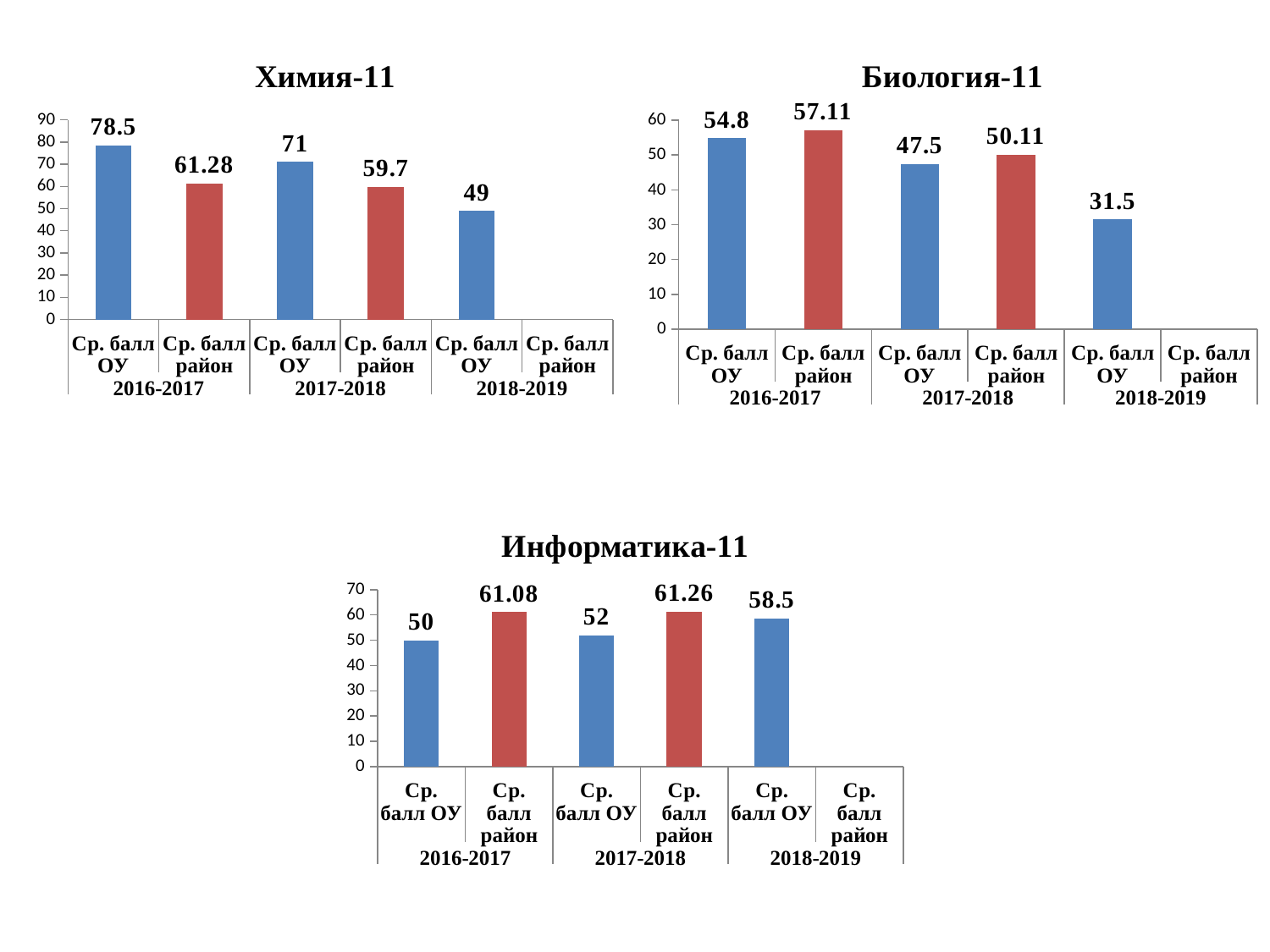
In the Химия-11 chart, what is the value for Ср. балл район in 2017-2018? 59.7 In the Химия-11 chart, what is the value for Ср. балл ОУ in 2016-2017? 78.5 How many bars are plotted in the Информатика-11 chart? 5 In the Биология-11 chart, which bar has the highest value? Ср. балл район 2016-2017 In the Информатика-11 chart, what is the difference between Ср. балл район and Ср. балл ОУ in 2017-2018? 9.26 What type of chart is the Химия-11 chart? Bar chart In the Химия-11 chart, which bar has the lowest value? Ср. балл ОУ 2018-2019 In the Химия-11 chart, what is the difference between Ср. балл ОУ and Ср. балл район in 2016-2017? 17.22 In the Биология-11 chart, what is the value for Ср. балл район in 2016-2017? 57.11 In the Информатика-11 chart, what is the value for Ср. балл ОУ in 2018-2019? 58.5 In the Биология-11 chart, how do the Ср. балл ОУ values change from 2016-2017 to 2018-2019? They fall In the Биология-11 chart, which is larger in 2017-2018: Ср. балл ОУ or Ср. балл район? Ср. балл район